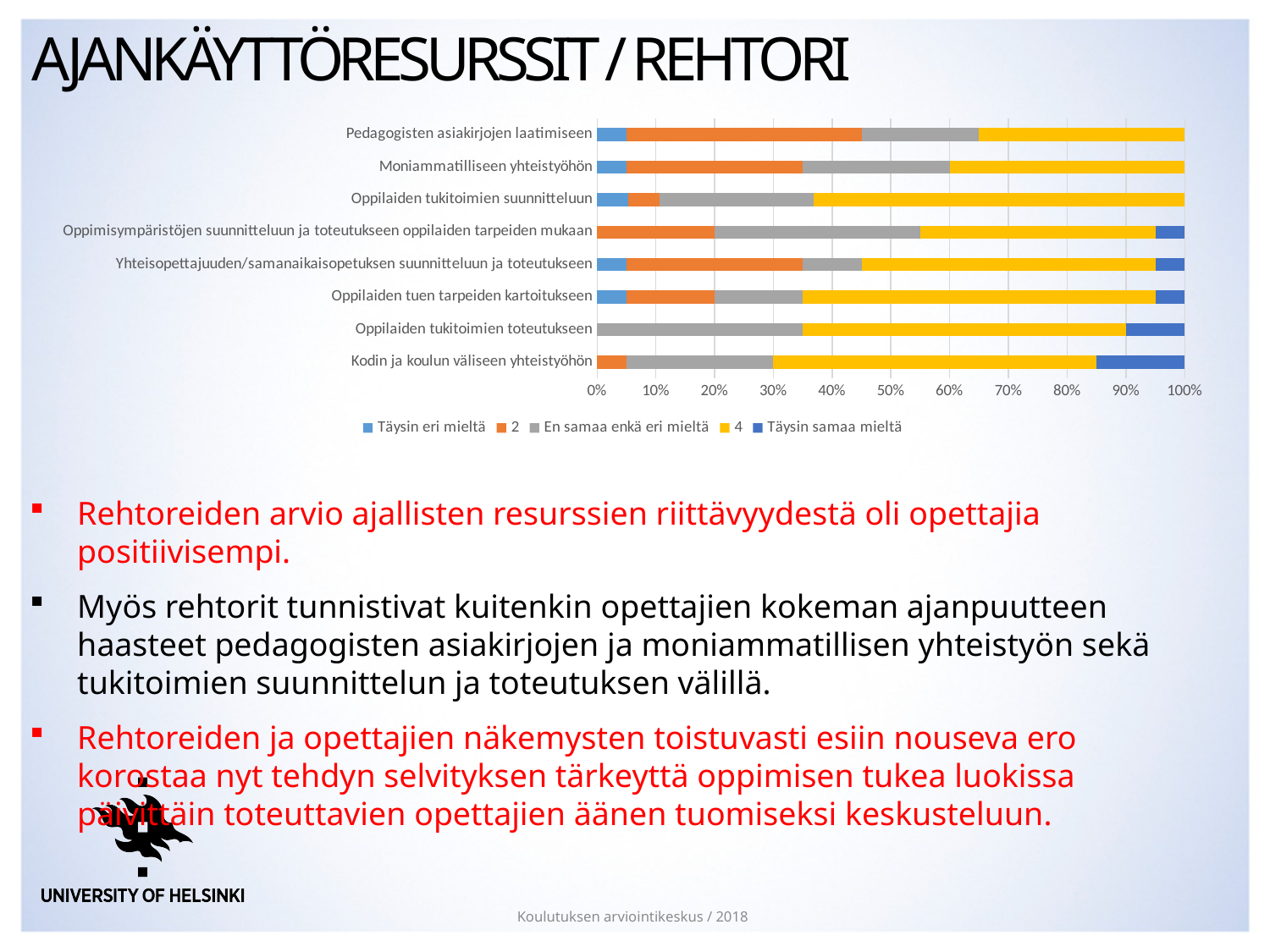
Is the 'Täysin samaa mieltä' segment for 'Kodin ja koulun väliseen yhteistyöhön' greater or less than 10%? greater How many categories have no 'Täysin samaa mieltä' segment at all? 3 Is the 'En samaa enkä eri mieltä' segment for 'Oppilaiden tukitoimien toteutukseen' greater or less than 30%? greater Which category has the largest 'Täysin samaa mieltä' segment? Kodin ja koulun väliseen yhteistyöhön What kind of chart is shown on the slide? Stacked bar chart Is the '4' segment for 'Oppilaiden tukitoimien suunnitteluun' greater or less than 50%? greater How many series does the chart legend list? 5 What is the last entry in the chart legend? Täysin samaa mieltä How many categories are plotted on the vertical axis of the chart? 8 Which has the larger '4' segment: 'Oppilaiden tukitoimien suunnitteluun' or 'Pedagogisten asiakirjojen laatimiseen'? Oppilaiden tukitoimien suunnitteluun Which category has the largest '2' segment? Pedagogisten asiakirjojen laatimiseen What is the first entry in the chart legend? Täysin eri mieltä